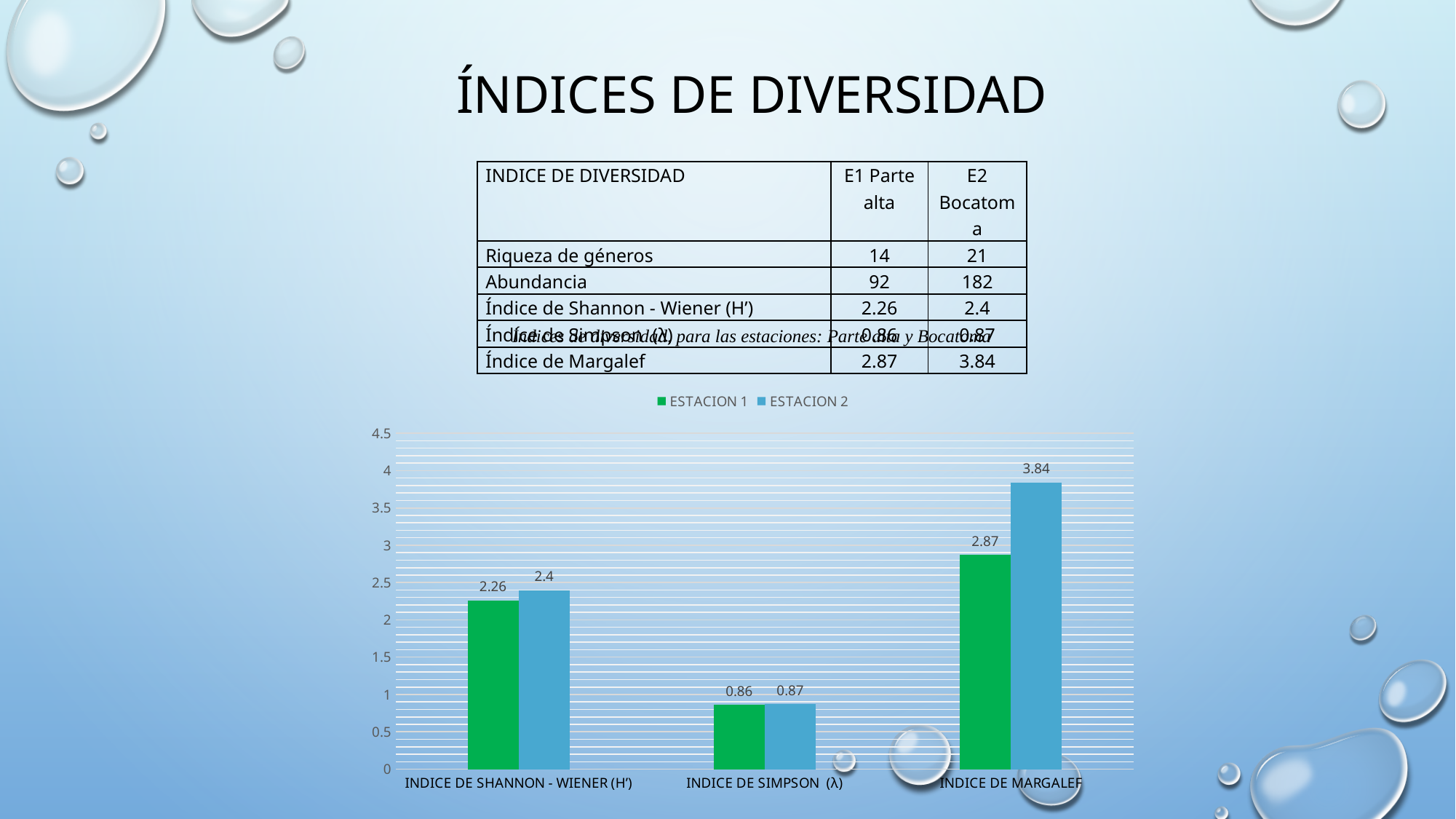
Is the value for ESTACION 2 in the INDICE DE MARGALEF category greater or less than 3.5? greater Which category has the highest value for ESTACION 2? INDICE DE MARGALEF Which category has the lowest value for ESTACION 1? INDICE DE SIMPSON (λ) How many categories are shown on the x axis of the chart? 3 Which is larger in the INDICE DE MARGALEF category: ESTACION 1 or ESTACION 2? ESTACION 2 What is the value for ESTACION 1 in the INDICE DE MARGALEF category? 2.87 What is the value for ESTACION 1 in the INDICE DE SIMPSON (λ) category? 0.86 What colour are the ESTACION 1 bars in the chart? green What kind of chart is shown on the slide? bar chart What is the difference between ESTACION 2 and ESTACION 1 in the INDICE DE MARGALEF category? 0.97 How many series does the chart legend list? 2 What is the value for ESTACION 2 in the INDICE DE SHANNON - WIENER (H') category? 2.4